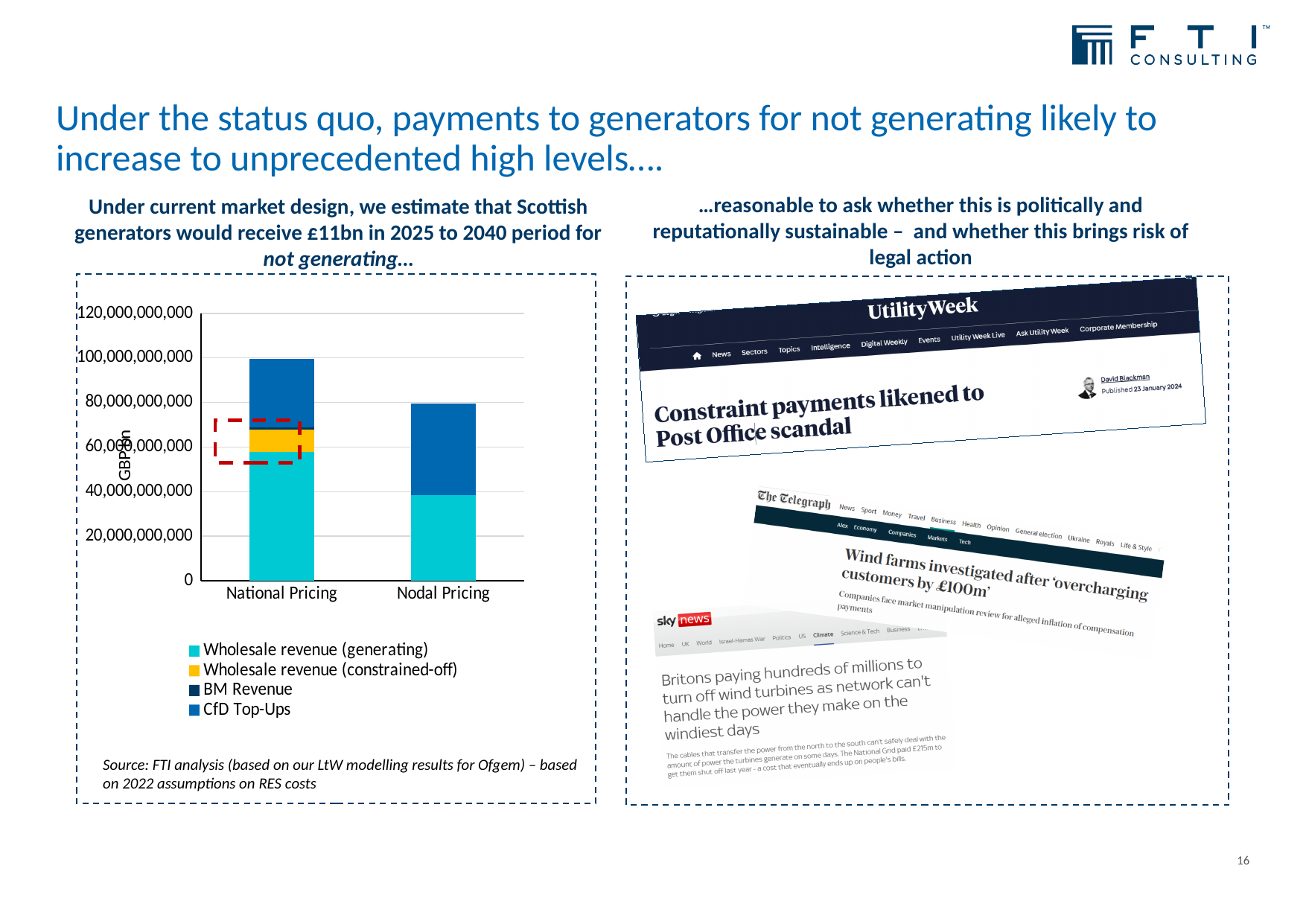
Which legend entry is shown in yellow? Wholesale revenue (constrained-off) How many series does the chart's legend list? 4 Which category has the lower total stacked bar? Nodal Pricing What kind of chart is shown on the left of the slide? Stacked bar chart Is the Wholesale revenue (generating) segment of the National Pricing bar greater or less than 40,000,000,000? greater Is the total height of the Nodal Pricing bar greater or less than 60,000,000,000? greater Is the Wholesale revenue (generating) segment of the Nodal Pricing bar greater or less than 60,000,000,000? less How many categories are shown on the x axis of the chart? 2 What is the highest value shown on the chart's y axis? 120,000,000,000 Which category has the taller stacked bar, National Pricing or Nodal Pricing? National Pricing